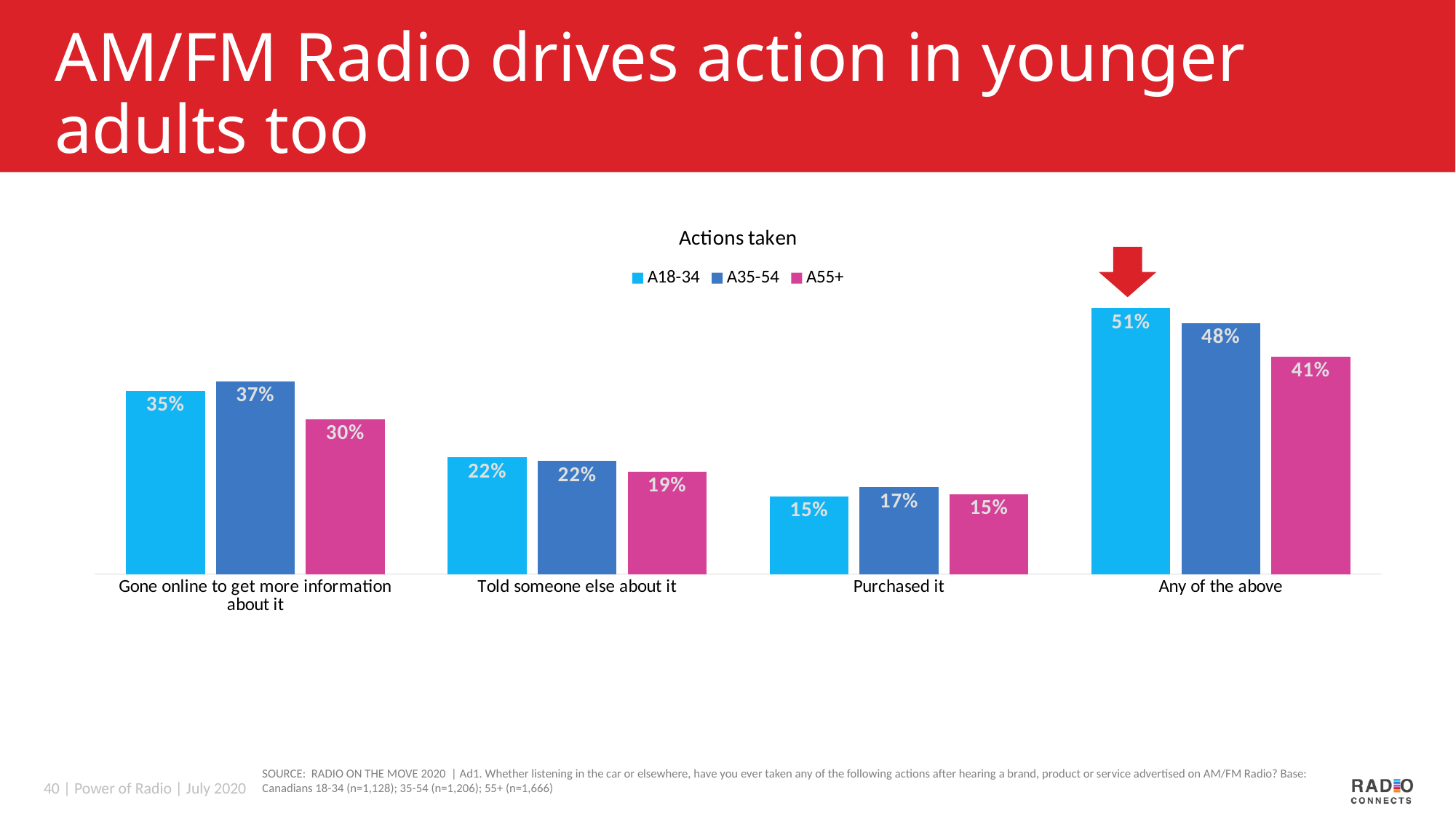
What is the value for A18-34 in the 'Any of the above' category? 51% What is the value for A55+ in the 'Gone online to get more information about it' category? 30% Which is larger in the 'Gone online to get more information about it' category: A18-34 or A35-54? A35-54 What is the title of the chart? Actions taken What kind of chart is shown on the slide? Bar chart How many series does the legend list? 3 What is the value for A35-54 in the 'Purchased it' category? 17% Which series is shown in pink? A55+ How many categories are shown on the x axis? 4 Which category has the lowest value for the A55+ series? Purchased it Which category has the highest value for the A18-34 series? Any of the above What is the difference between the A18-34 and A55+ values in the 'Any of the above' category? 10%